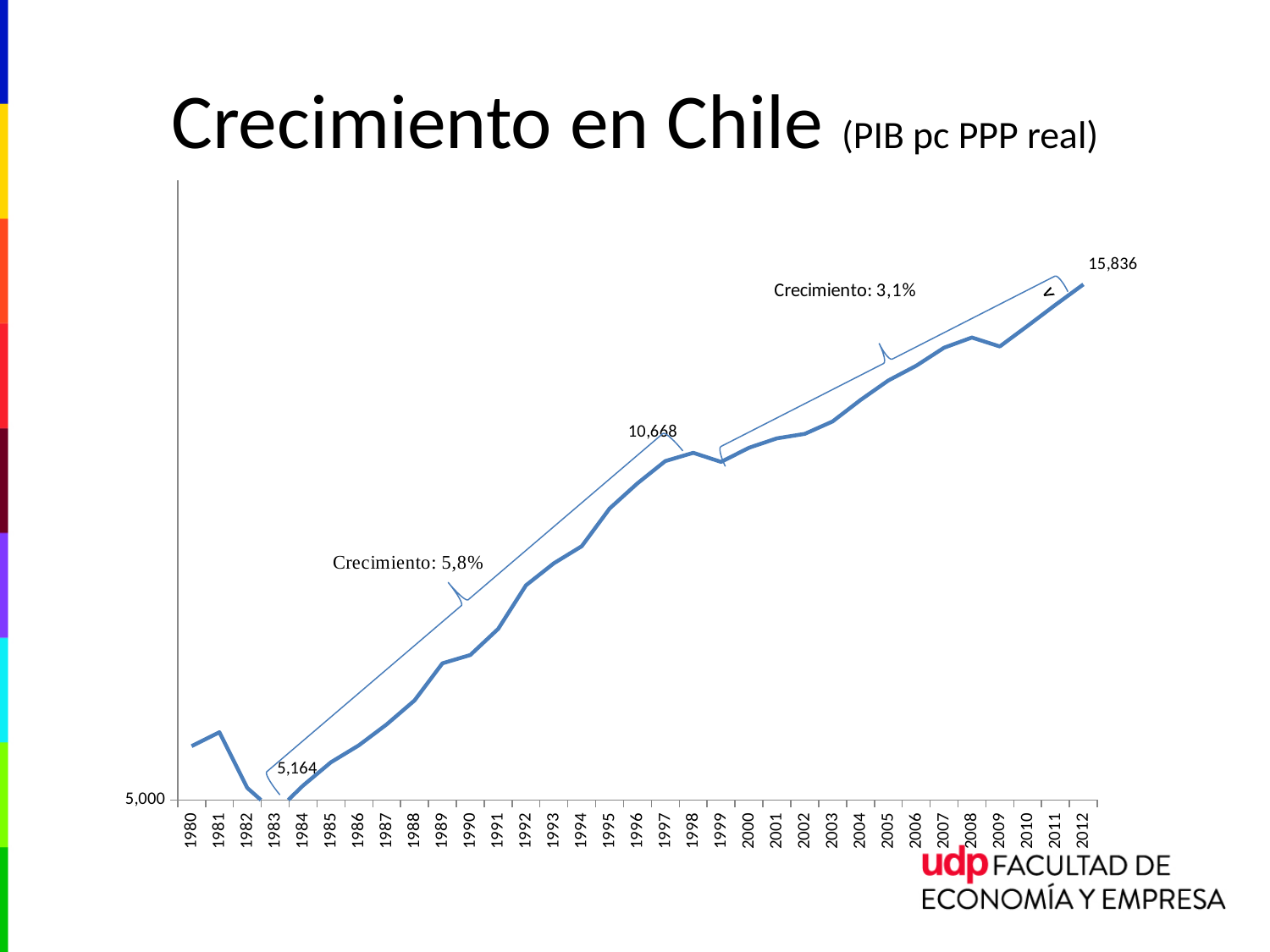
What is the difference between the labelled values for 2012 and 1997? 5,168 What is the value labelled for 2012? 15,836 Which year has the highest value on the chart? 2012 Which is larger, the value for 1997 or the value for 2012? 2012 Is the value for 1980 greater or less than 5,000? greater What is the value labelled for 1997? 10,668 Does the line generally rise or fall from 1983 to 2012? rise What kind of chart is shown on the slide? line chart What growth rate is annotated for the period from 1983 to 1997? 5,8%